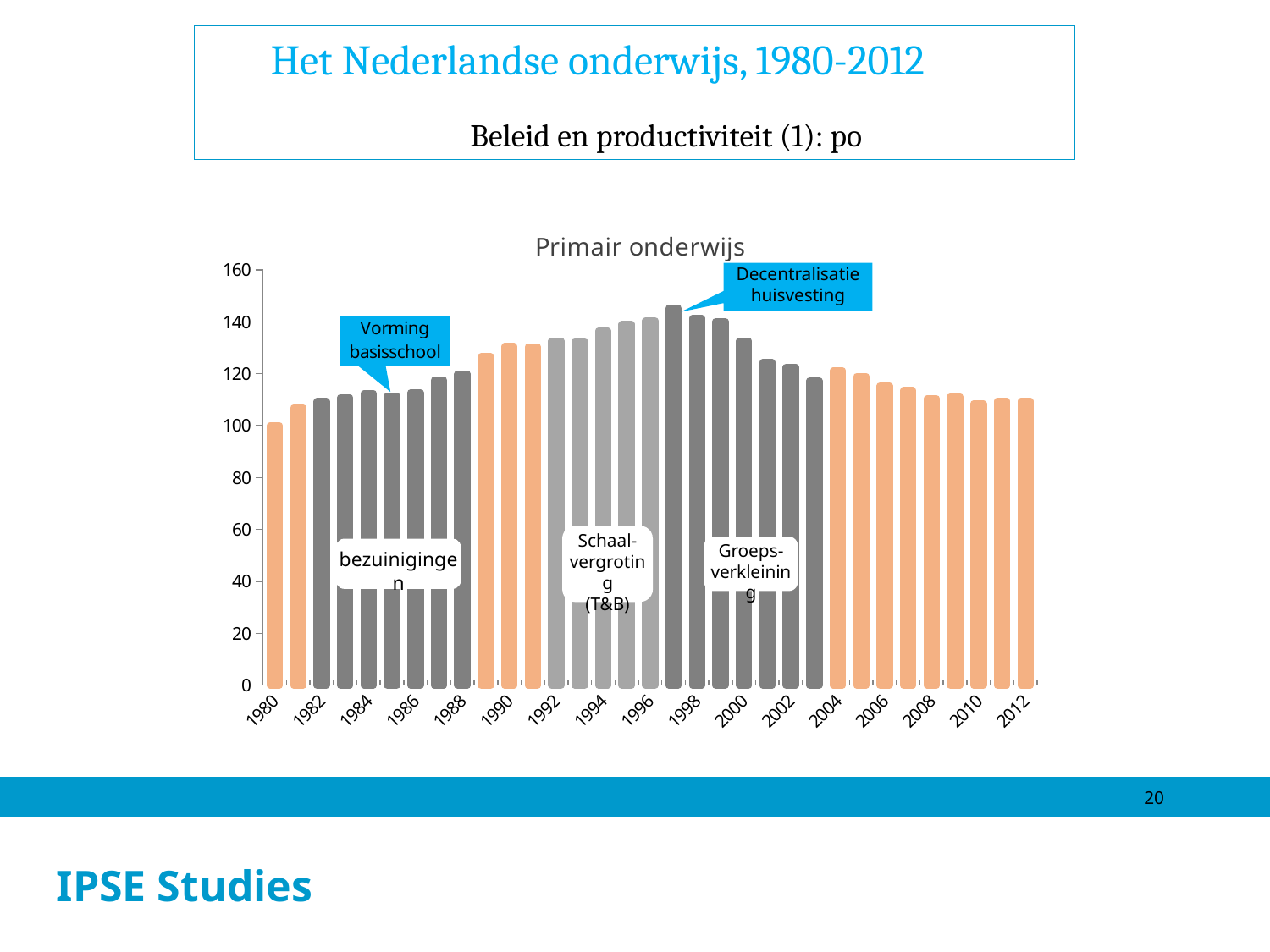
Do the values generally rise or fall from 1997 to 2012? fall Which year has the highest bar in the chart? 1997 Is the value for 1980 greater or less than 120? less What is the title of the chart? Primair onderwijs Is the value for 1997 greater or less than 140? greater What kind of chart is shown on the slide? bar chart Which policy label is attached to the highest bar in the chart? Decentralisatie huisvesting Is the value for 2012 greater or less than 120? less How many years (bars) are plotted in the chart? 33 Which year has the lowest bar in the chart? 1980 Which is larger, the value for 1990 or the value for 2012? 1990